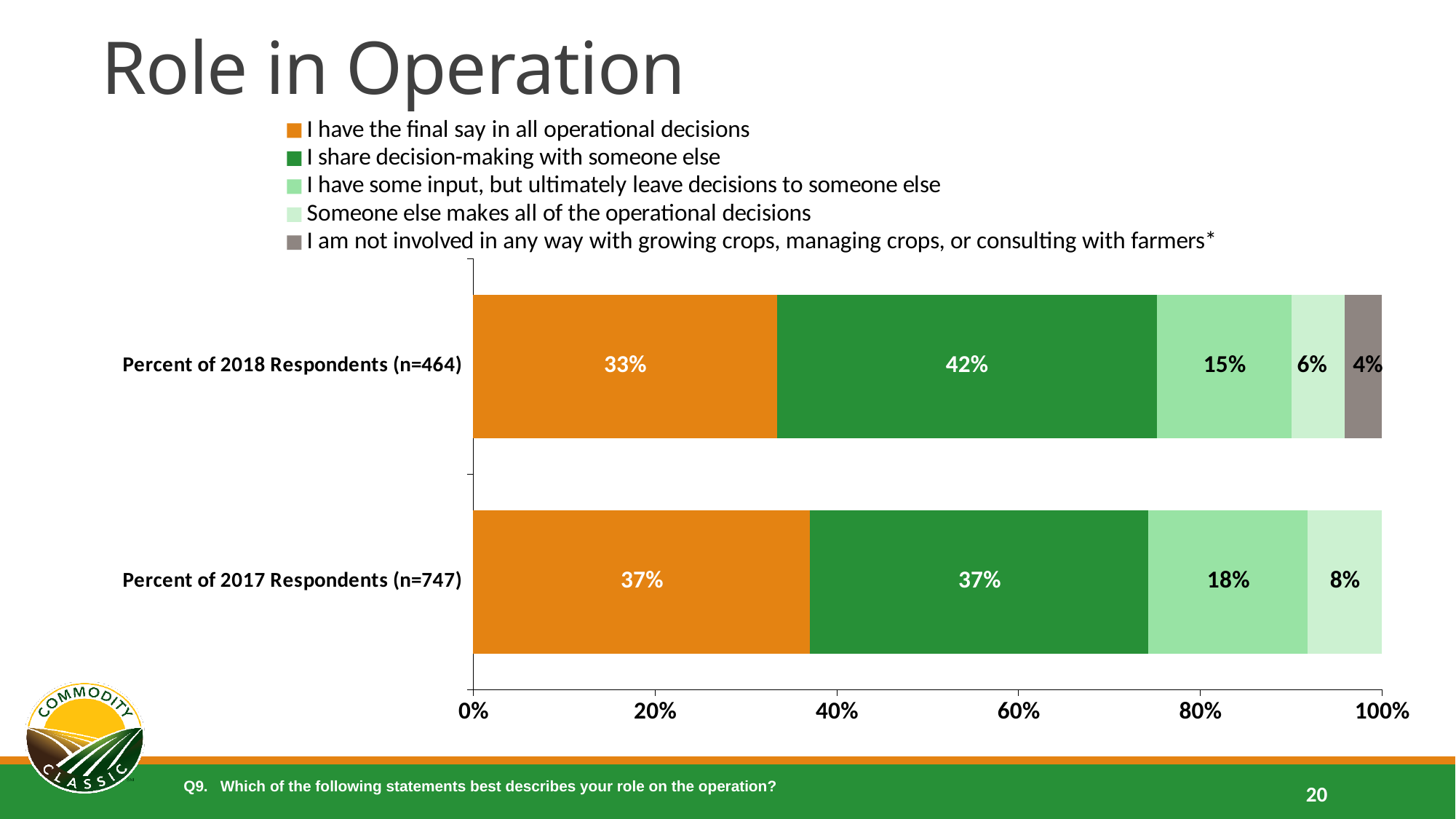
What percentage of 2018 respondents said they are not involved in any way with growing crops, managing crops, or consulting with farmers? 4% Which response category has the smallest share among 2018 respondents? I am not involved in any way with growing crops, managing crops, or consulting with farmers* Which response category has the largest share among 2018 respondents? I share decision-making with someone else What colour represents 'I have the final say in all operational decisions' in the chart? Orange What kind of chart is shown on the slide? Stacked bar chart How many respondent groups (bars) are shown in the chart? 2 What percentage of 2017 respondents said someone else makes all of the operational decisions? 8% What is the difference between the 2018 and 2017 percentages for 'I share decision-making with someone else'? 5% What percentage of 2018 respondents said they have the final say in all operational decisions? 33% How many series does the legend list? 5 What percentage of 2017 respondents said they share decision-making with someone else? 37% Which year had a higher percentage of respondents saying they have the final say in all operational decisions, 2018 or 2017? 2017